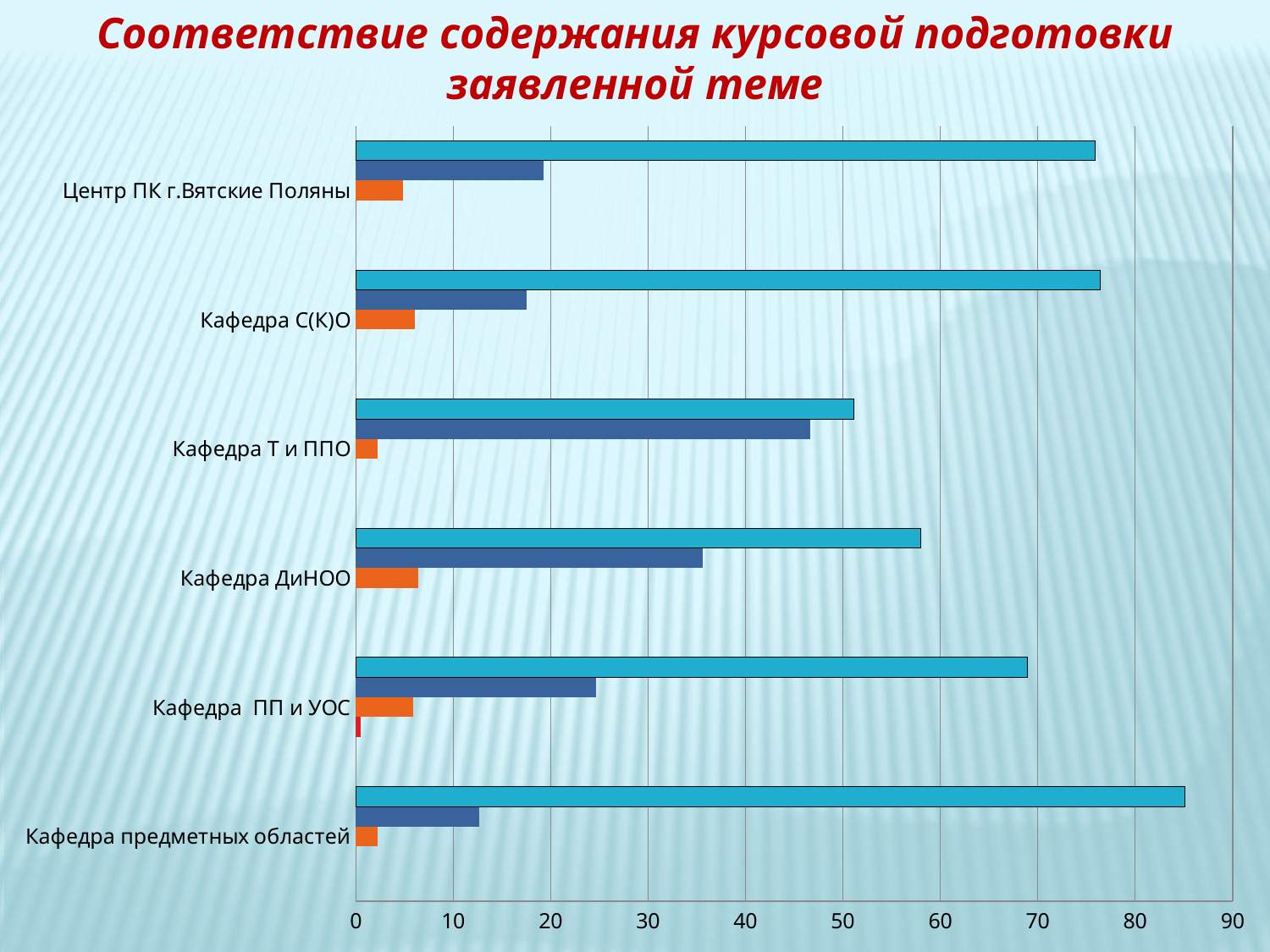
Is the light blue bar for Кафедра ПП и УОС greater or less than 60? greater Is the dark blue bar for Кафедра Т и ППО greater or less than 40? greater Which category has the shortest light blue bar? Кафедра Т и ППО Which category has the longest dark blue bar? Кафедра Т и ППО What is the title of the chart on the slide? Соответствие содержания курсовой подготовки заявленной теме Which category has the longest light blue bar? Кафедра предметных областей What kind of chart is shown on the slide? bar chart How many categories (departments) are shown on the chart? 6 Which category has the shortest dark blue bar? Кафедра предметных областей Is the light blue bar for Кафедра Т и ППО greater or less than 60? less Which has the longer light blue bar: Центр ПК г.Вятские Поляны or Кафедра ДиНОО? Центр ПК г.Вятские Поляны